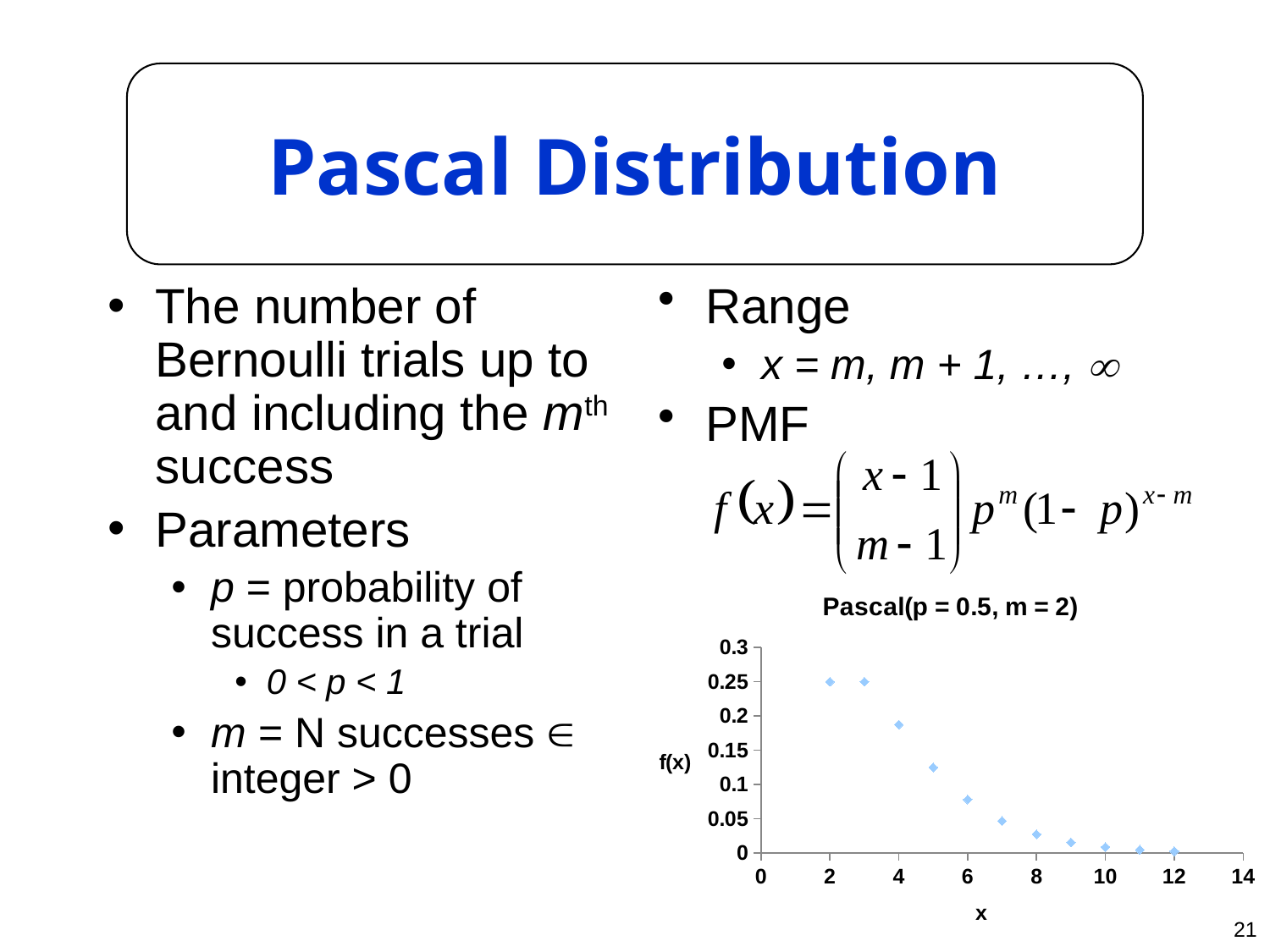
What is the label of the vertical axis of the chart? f(x) What is the value of f(x) at x = 2? 0.25 Is the value of f(x) at x = 5 greater or less than 0.1? greater What type of chart is shown on the slide? scatter chart How many data points are plotted in the chart? 11 Is the value of f(x) at x = 4 greater or less than 0.15? greater Is the value of f(x) at x = 6 greater or less than 0.1? less What is the title of the chart? Pascal(p = 0.5, m = 2) What is the value of f(x) at x = 3? 0.25 Do the values of f(x) rise or fall as x increases from 3 to 12? fall Which has the larger value of f(x): x = 4 or x = 8? x = 4